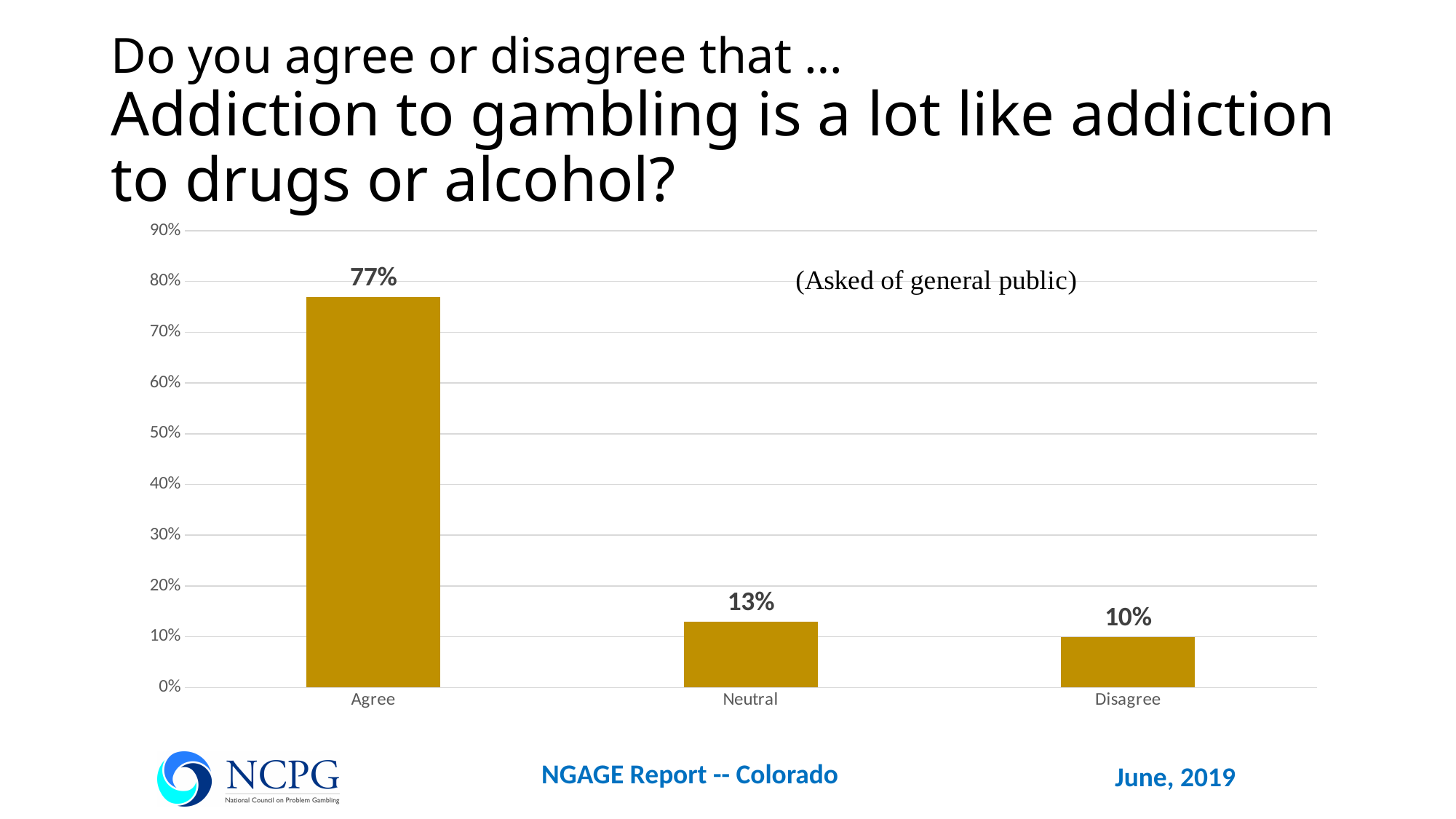
How many categories are shown on the x axis? 3 What is the difference between the Agree and Disagree values? 67% What percentage of respondents agree that addiction to gambling is a lot like addiction to drugs or alcohol? 77% Which category has the highest value? Agree According to the note on the chart, who was this question asked of? General public Which category has the lowest value? Disagree Which is larger, the value for Neutral or the value for Disagree? Neutral Is the value for Agree greater or less than 70%? greater What is the value shown for Neutral? 13% What is the difference between the Neutral and Disagree values? 3% What is the value shown for Disagree? 10% What kind of chart is shown on the slide? Bar chart